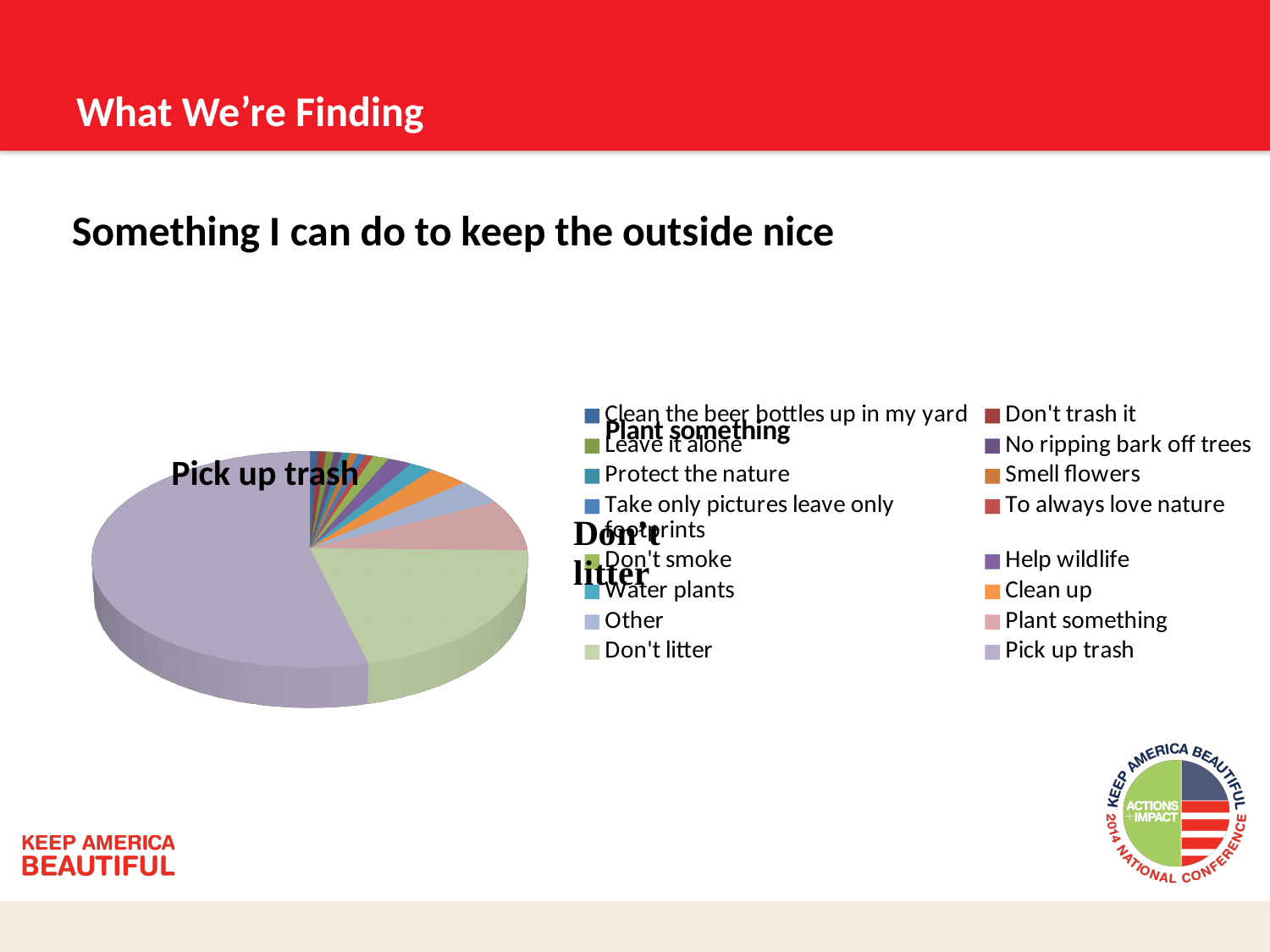
Which slice is larger, Plant something or Other? Plant something Which category has the largest slice of the pie? Pick up trash Is the share of the pie for Pick up trash greater or less than 50%? greater Which slice is larger, Pick up trash or Don't litter? Pick up trash Which slice is larger, Don't litter or Plant something? Don't litter Which category has the second-largest slice of the pie? Don't litter What is the title of the chart? Something I can do to keep the outside nice How many categories does the legend list? 16 What kind of chart is shown on the slide? pie chart Which legend entry is listed last in the right-hand column of the legend? Pick up trash